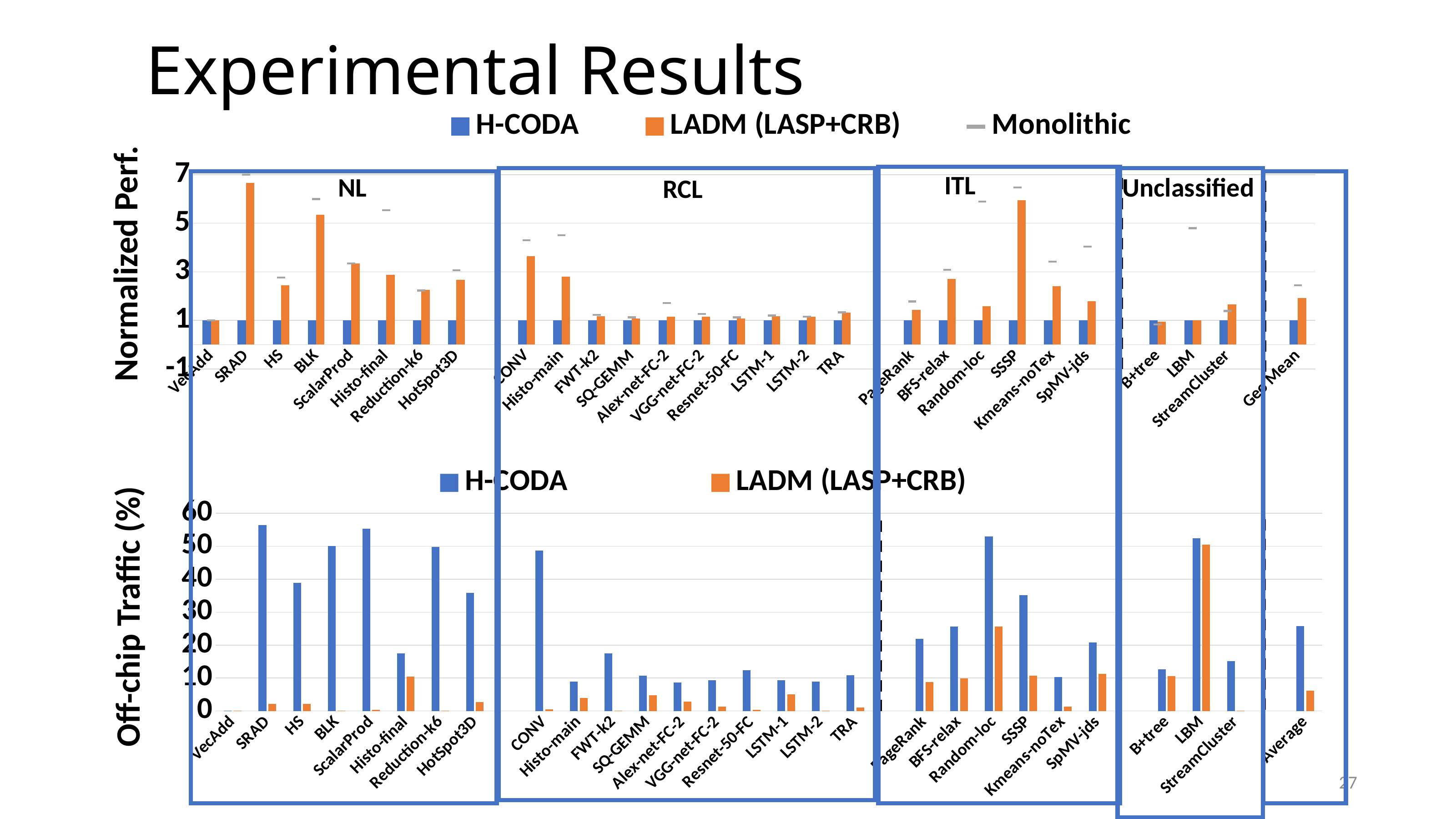
In the top chart (Normalized Perf.), is the LADM (LASP+CRB) value for HS greater or less than 3? less In the top chart (Normalized Perf.), which benchmark has the highest LADM (LASP+CRB) value? SRAD How many series does the legend of the bottom chart (Off-chip Traffic (%)) list? 2 In the bottom chart (Off-chip Traffic (%)), which is larger: the LADM (LASP+CRB) value for Random-loc or for SSSP? Random-loc In the bottom chart (Off-chip Traffic (%)), which is larger: the H-CODA value for BLK or the H-CODA value for HS? BLK In the top chart (Normalized Perf.), is the LADM (LASP+CRB) value for SSSP greater or less than 5? greater How many series does the legend of the top chart (Normalized Perf.) list? 3 In the bottom chart (Off-chip Traffic (%)), is the H-CODA value for SRAD greater or less than 50? greater What kind of chart is the bottom chart (Off-chip Traffic (%))? bar chart In the bottom chart (Off-chip Traffic (%)), which benchmark has the highest LADM (LASP+CRB) value? LBM How many benchmarks are in the ITL group of the top chart (Normalized Perf.)? 6